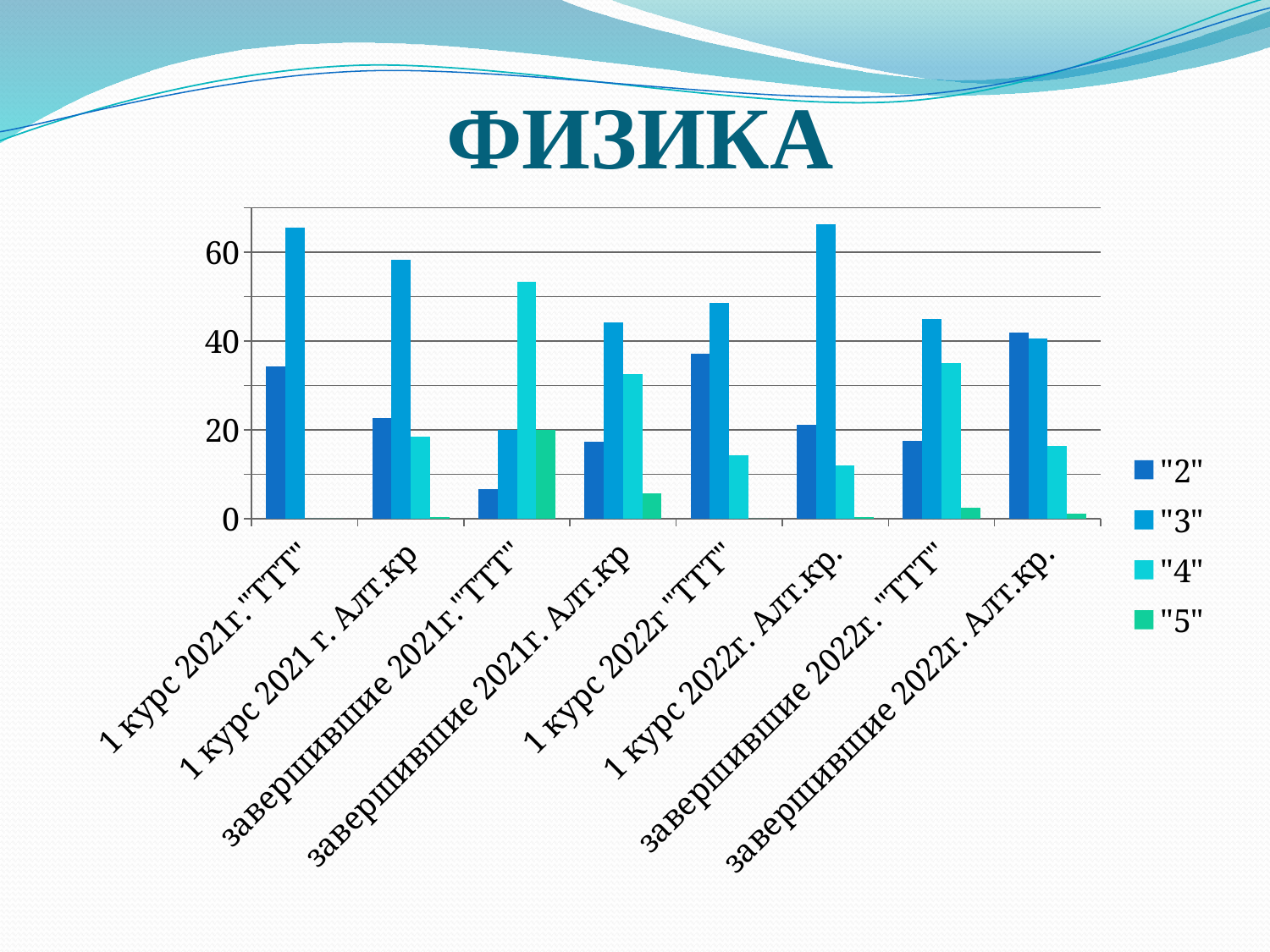
Is the value of the "2" series for 1 курс 2021г."ТТТ" greater or less than 20? greater Which category has the lowest value for the "2" series? завершившие 2021г."ТТТ" How many categories are shown on the x axis? 8 Which category has the highest value for the "5" series? завершившие 2021г."ТТТ" What kind of chart is shown on the slide? bar chart What is the title of the slide above the chart? ФИЗИКА For 1 курс 2022г "ТТТ", which series has the larger value, "2" or "4"? "2" Is the value of the "3" series for 1 курс 2021 г. Алт.кр greater or less than 40? greater How many series does the legend list? 4 For завершившие 2021г."ТТТ", which series has the larger value, "3" or "4"? "4" Is the value of the "5" series for завершившие 2021г. Алт.кр greater or less than 20? less Which category has the highest value for the "4" series? завершившие 2021г."ТТТ"